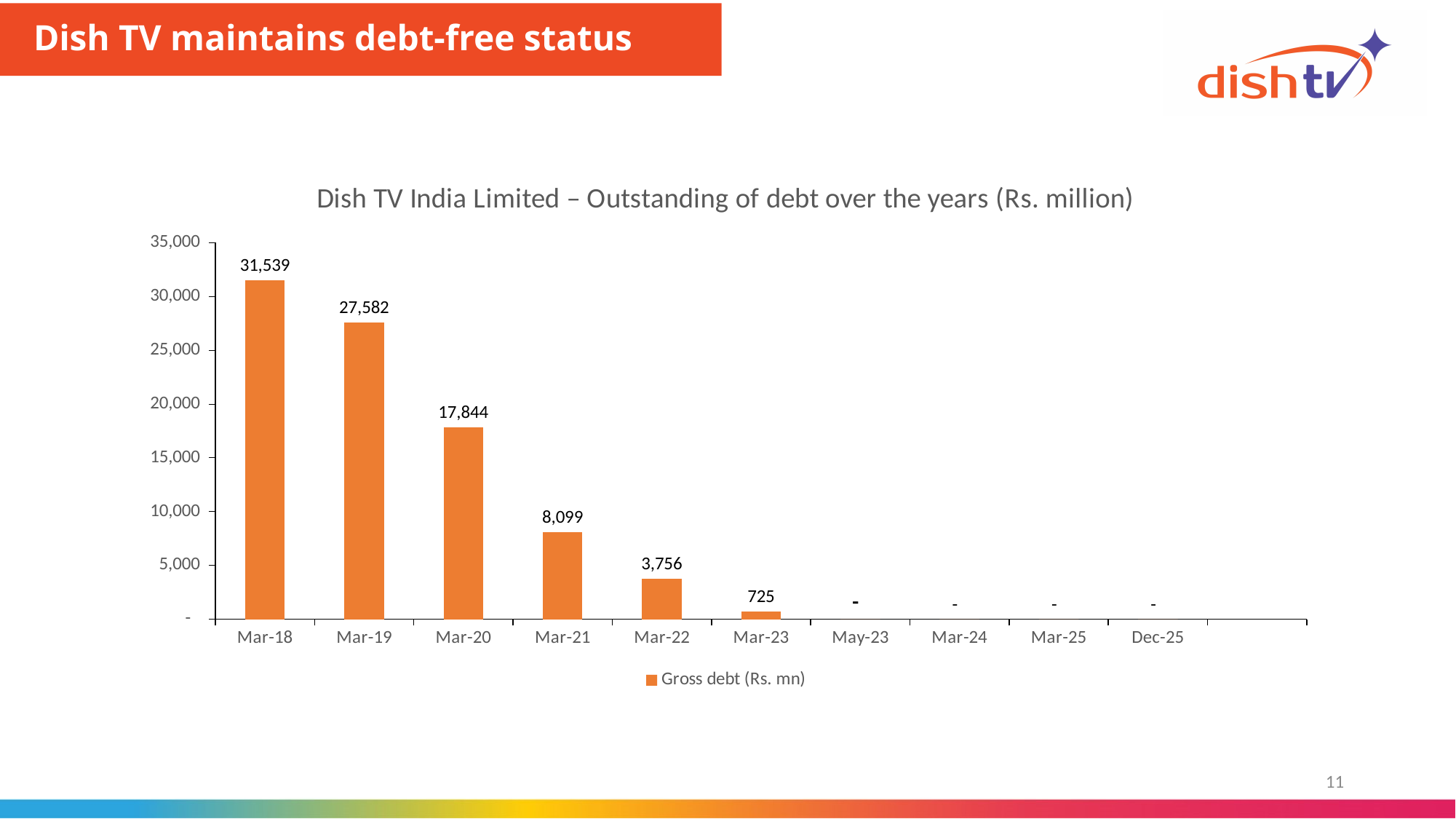
What is the gross debt for Mar-18? 31,539 Which period has the highest gross debt? Mar-18 Do the gross debt values rise or fall from Mar-18 to Mar-23? fall Which is larger, the gross debt for Mar-20 or for Mar-21? Mar-20 Is the gross debt for Mar-19 greater or less than 25,000? greater What is the difference in gross debt between Mar-21 and Mar-22? 4,343 What is the gross debt for Mar-20? 17,844 What is the difference in gross debt between Mar-18 and Mar-19? 3,957 What is the gross debt for Mar-23? 725 How many periods are shown on the x axis? 10 What is the title of the chart? Dish TV India Limited – Outstanding of debt over the years (Rs. million) What kind of chart is shown on the slide? bar chart